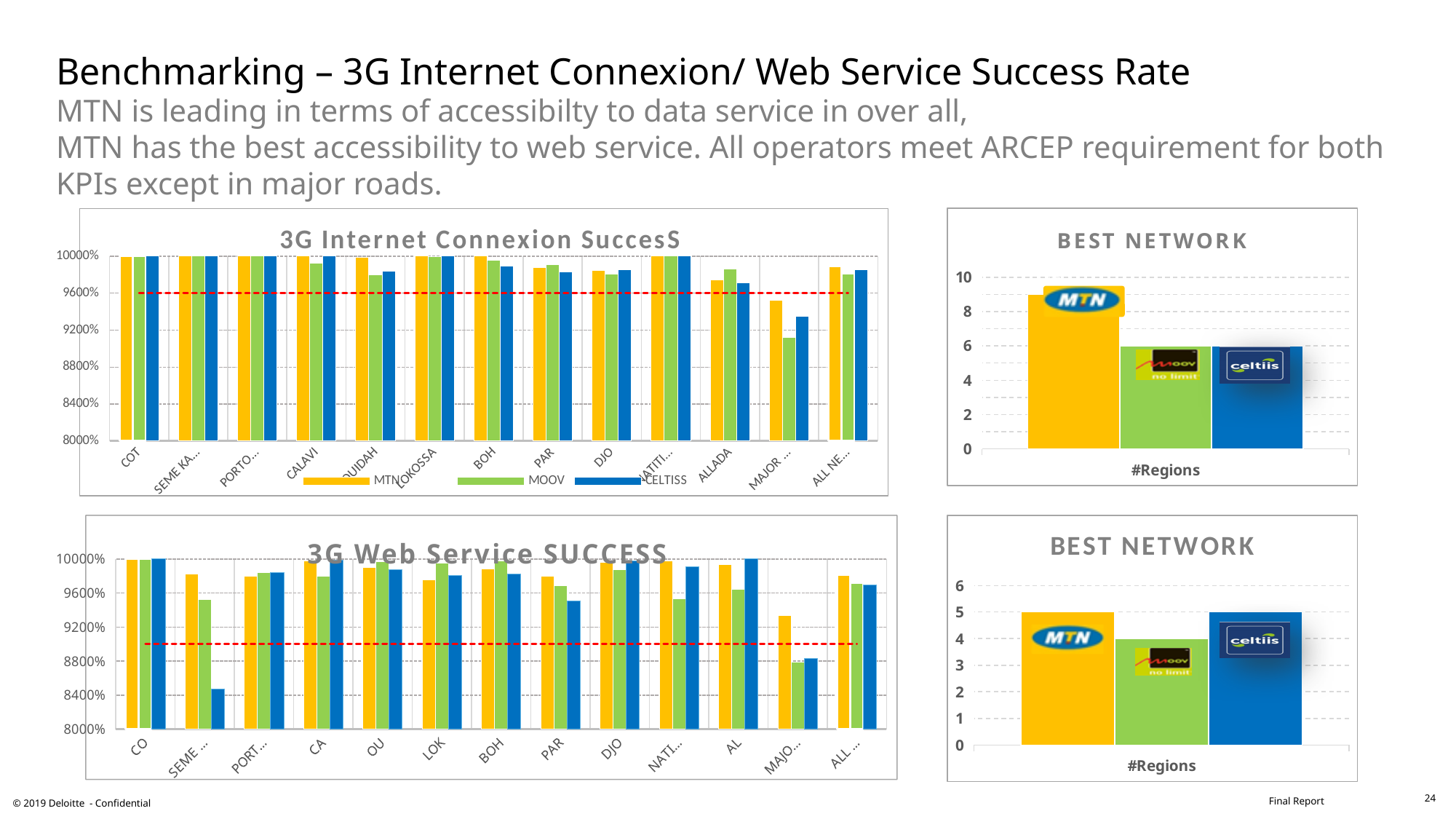
How many categories are shown on the x axis of the '3G Internet Connexion SuccesS' chart? 13 How many series does the legend of the '3G Internet Connexion SuccesS' chart list? 3 In the '3G Internet Connexion SuccesS' chart, is the MOOV value for MAJOR greater or less than 9200%? less In the top-right 'BEST NETWORK' chart, is the value for MOOV greater or less than 8? less In the top-right 'BEST NETWORK' chart, which network has the highest number of regions? MTN In the top-right 'BEST NETWORK' chart, is the value for MTN greater or less than 8? greater What kind of chart is the '3G Internet Connexion SuccesS' chart? combination bar and line chart What is the x-axis label of the bottom-right 'BEST NETWORK' chart? #Regions In the bottom-right 'BEST NETWORK' chart, which network has the lowest number of regions? MOOV In the '3G Web Service SUCCESS' chart, which series has the lowest bar for the SEME category? CELTISS In the '3G Internet Connexion SuccesS' chart, which series has the lowest bar for the MAJOR category? MOOV